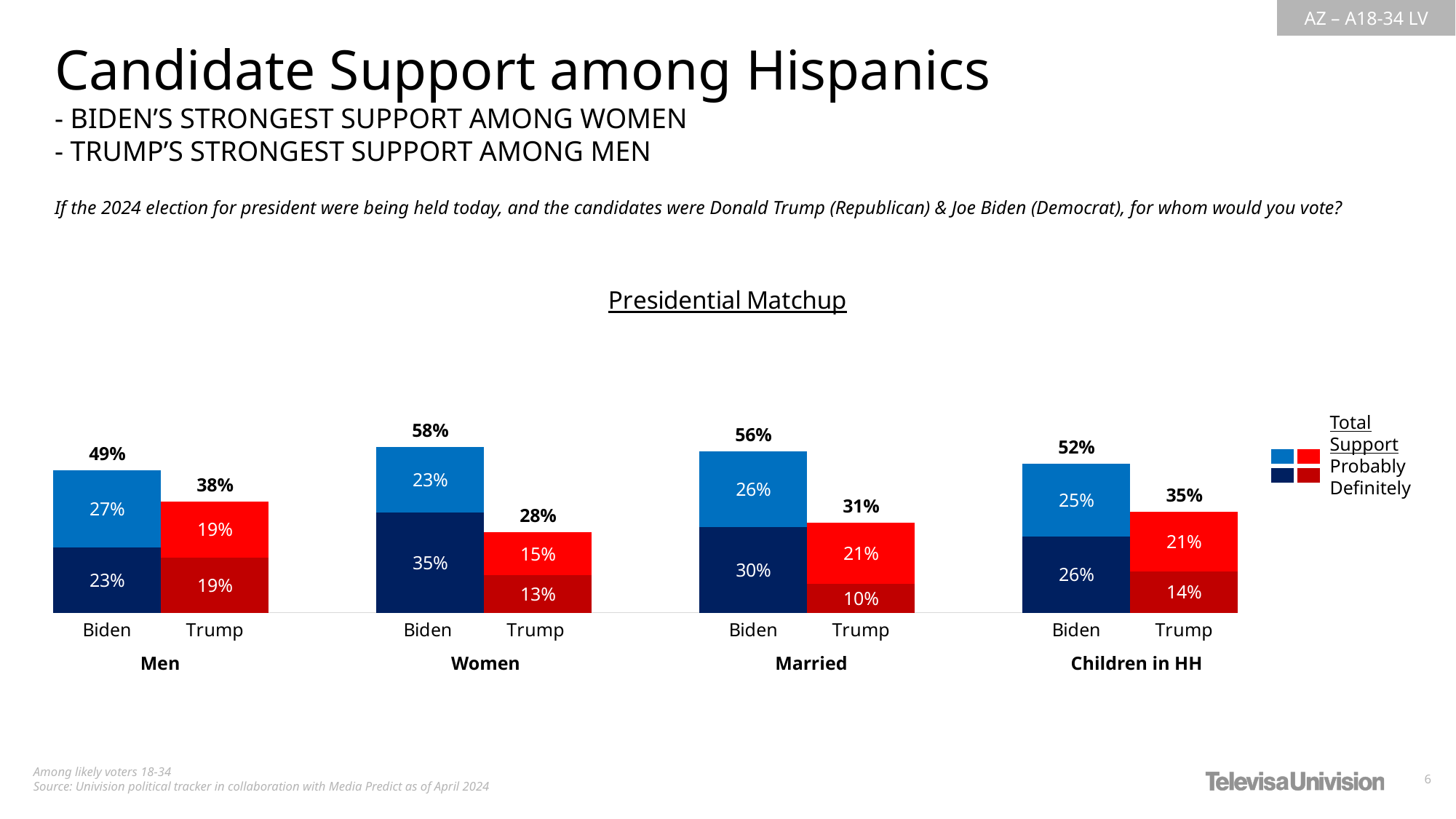
How many series does the legend of the Presidential Matchup chart list? 2 What is the difference between Biden's and Trump's total support among Men in the Presidential Matchup chart? 11% What is the total support for Biden among Women in the Presidential Matchup chart? 58% What kind of chart is the Presidential Matchup chart? Stacked bar chart Among Married voters, who has higher total support in the Presidential Matchup chart, Biden or Trump? Biden What is the 'Definitely' support for Trump among Married voters in the Presidential Matchup chart? 10% In which group does Trump have the lowest total support in the Presidential Matchup chart? Women What is the total of the stacked bar for Trump among Children in HH in the Presidential Matchup chart? 35% In which group does Biden have the highest total support in the Presidential Matchup chart? Women How many demographic groups are shown in the Presidential Matchup chart? 4 What is the 'Probably' support for Biden among Men in the Presidential Matchup chart? 27% What is the title of the chart on the slide? Presidential Matchup